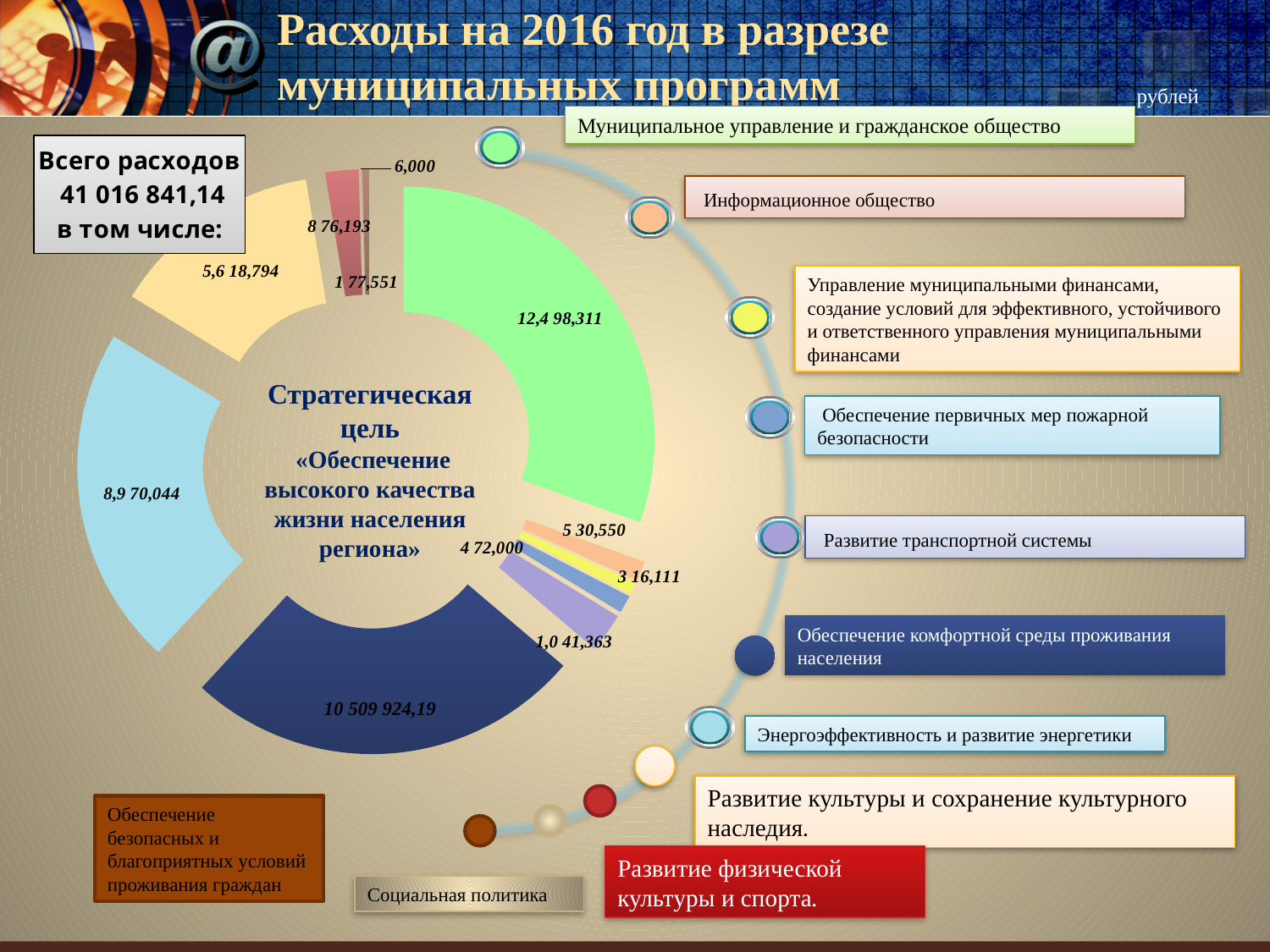
What is the total expenditure figure shown in the box at the top left of the slide? 41 016 841,14 What value is labelled on the light blue slice on the left of the chart? 8,9 70,044 What value is labelled on the large green slice on the right of the chart? 12,4 98,311 What kind of chart is shown on the slide? pie chart (donut) What value is labelled on the large dark blue slice at the bottom of the chart? 10 509 924,19 What is the title of the slide? Расходы на 2016 год в разрезе муниципальных программ How many slices (data labels) does the chart have? 11 How many municipal programmes are listed as legend entries around the chart? 11 What is the smallest value labelled on the chart? 6,000 Which slice is larger: the light blue slice labelled 8,9 70,044 or the pale yellow slice labelled 5,6 18,794? the light blue slice (8,9 70,044) What value is labelled on the pale yellow slice at the top left of the chart? 5,6 18,794 What value is labelled on the red slice at the top of the chart? 8 76,193